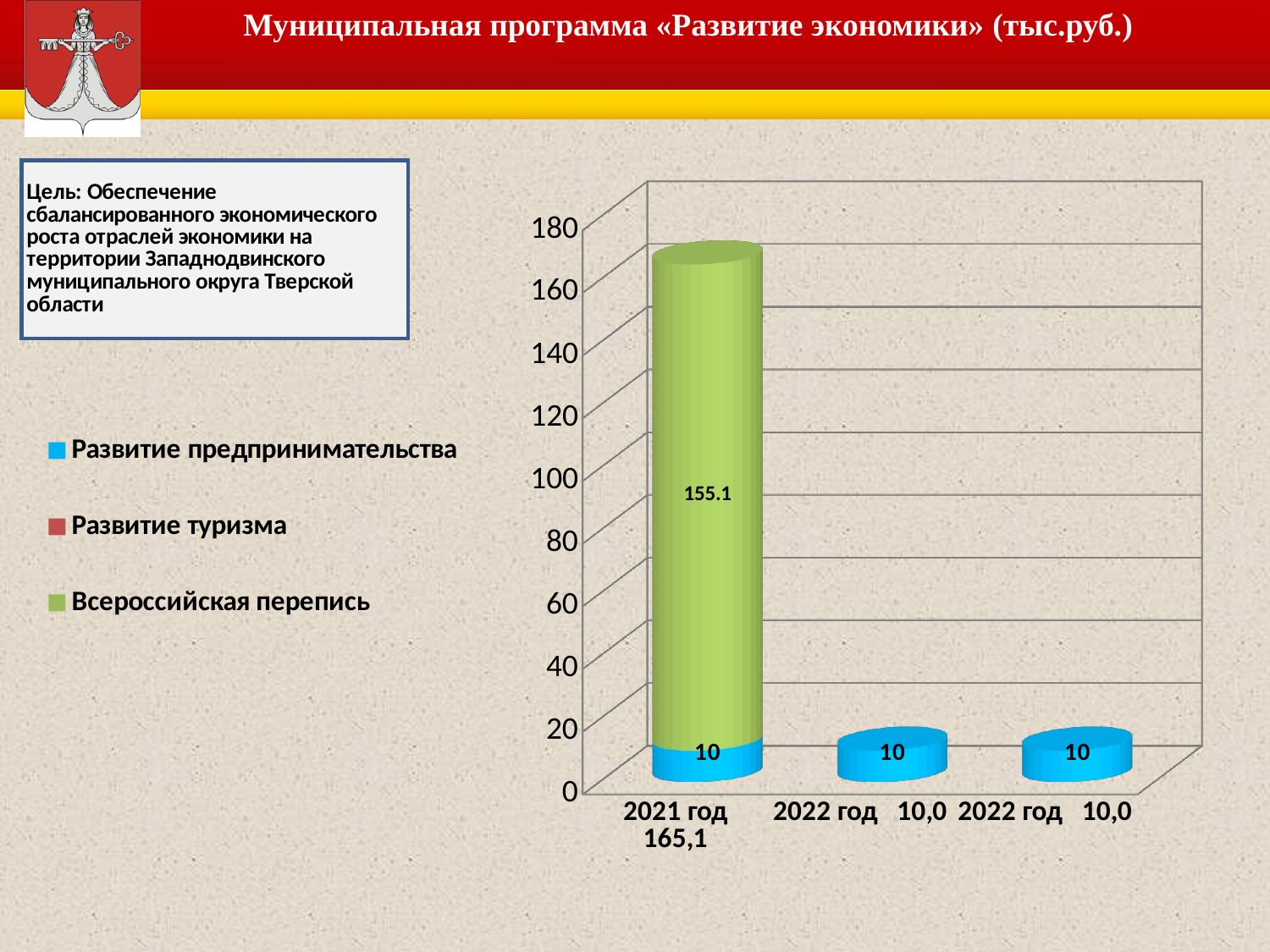
In 2021 год, which is larger: Всероссийская перепись or Развитие предпринимательства? Всероссийская перепись What colour represents Всероссийская перепись in the legend? green Which category has the tallest stacked bar? 2021 год Is the total of the 2021 год bar greater or less than 160? greater How many categories are shown along the x axis of the chart? 3 What is the total of the stacked bar for 2021 год? 165,1 What kind of chart is shown on the slide? bar chart What is the value of Развитие предпринимательства in the middle category (2022 год)? 10 What is the difference between Всероссийская перепись and Развитие предпринимательства in 2021 год? 145.1 What is the value of Всероссийская перепись for 2021 год? 155.1 What is the value of Развитие предпринимательства for 2021 год? 10 How many series does the chart legend list? 3